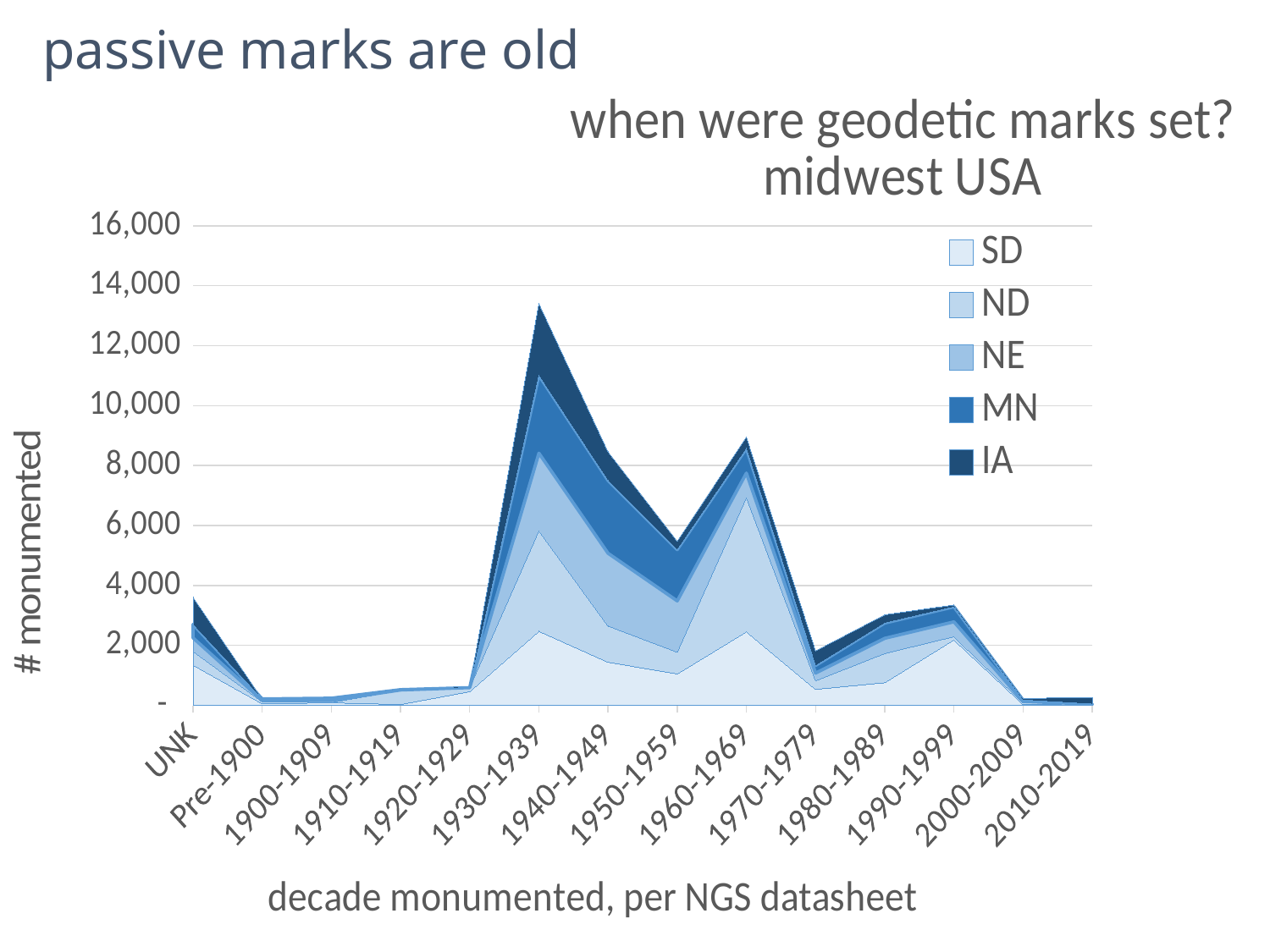
Is the total value for 1930-1939 greater or less than 12,000? greater Do the total values rise or fall from 1960-1969 to 1970-1979? fall How many decade categories are shown on the x axis? 14 What is the title of the chart? when were geodetic marks set? midwest USA Is the total value for 1990-1999 greater or less than 4,000? less How many series does the legend list? 5 Which has a larger total, 1940-1949 or 1950-1959? 1940-1949 What is the label of the x axis? decade monumented, per NGS datasheet Is the total value for 1960-1969 greater or less than 8,000? greater Which decade category has the highest total number of marks monumented? 1930-1939 What kind of chart is shown on the slide? stacked area chart